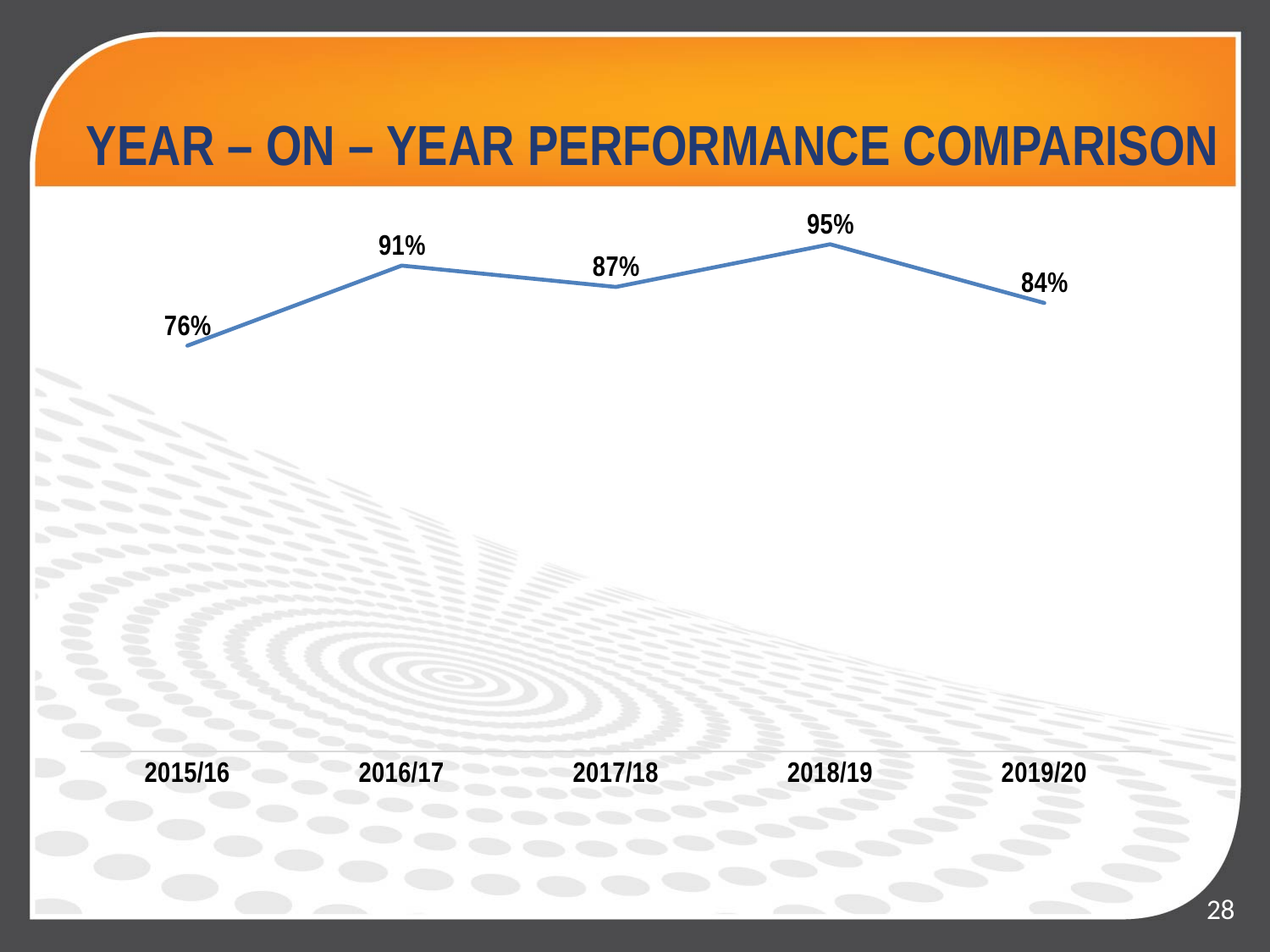
Which year has the lowest value? 2015/16 What is the title of the slide containing the chart? YEAR – ON – YEAR PERFORMANCE COMPARISON What is the difference between the values for 2018/19 and 2015/16? 19% What is the value for 2019/20? 84% Does the value rise or fall from 2018/19 to 2019/20? Fall What is the value for 2015/16? 76% What kind of chart is shown on the slide? Line chart Which year has the highest value? 2018/19 How many years are plotted on the chart? 5 Which is larger, the value for 2016/17 or the value for 2019/20? 2016/17 What is the difference between the values for 2016/17 and 2017/18? 4% What is the value for 2017/18? 87%